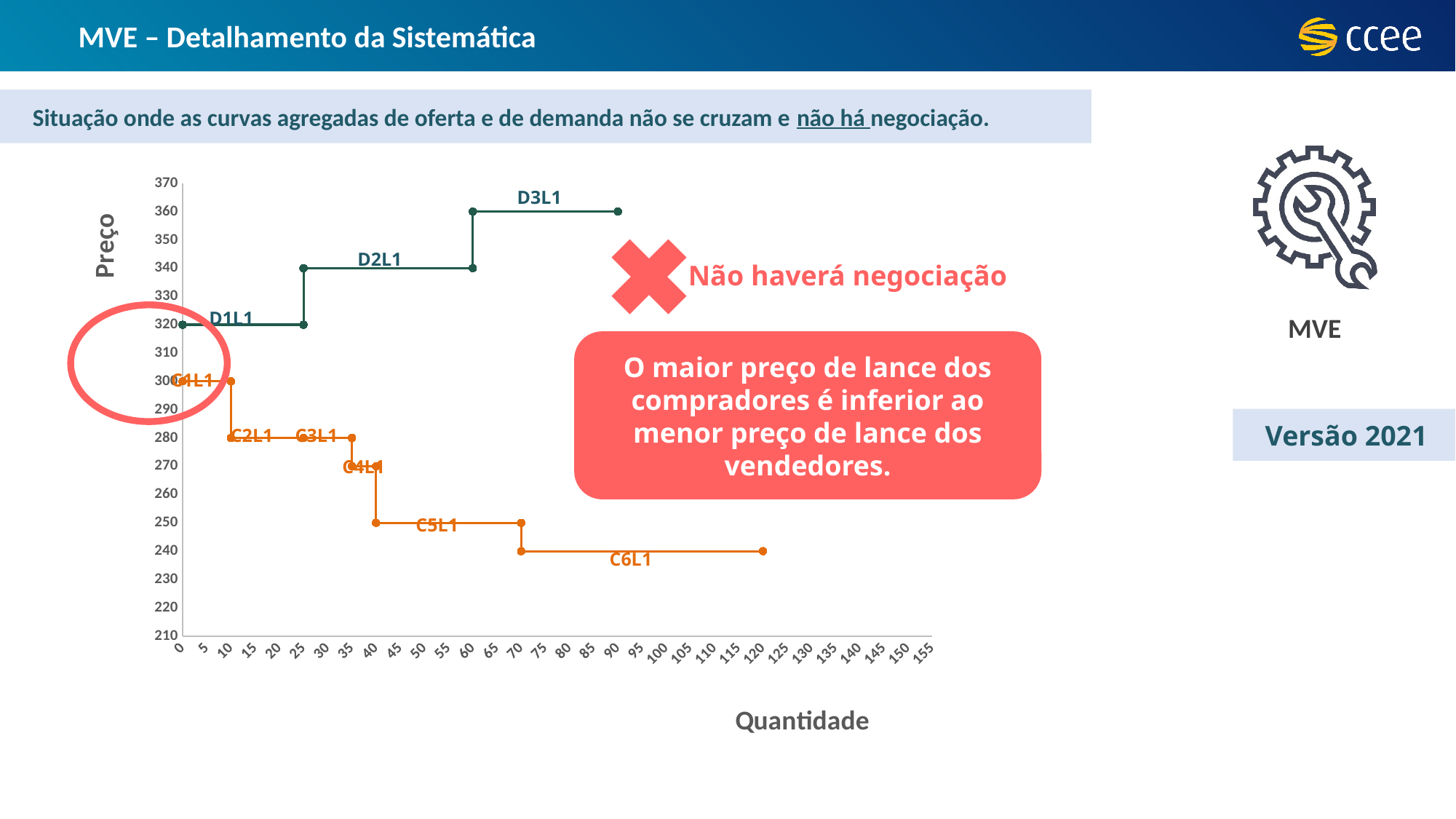
Do the prices of the orange steps (C1L1 to C6L1) rise or fall as quantity increases? fall Which is at a higher price, D2L1 or C3L1? D2L1 Which labelled step has the lowest price? C6L1 At what price level does the D1L1 step lie? 320 At what price level does the C6L1 step lie? 240 At what price level does the D3L1 step lie? 360 What is the difference in price between the D1L1 step and the C1L1 step? 20 What is the label of the x axis? Quantidade What kind of chart is shown on the slide? line chart At what price level does the C5L1 step lie? 250 Which labelled step has the highest price? D3L1 What is the label of the y axis? Preço